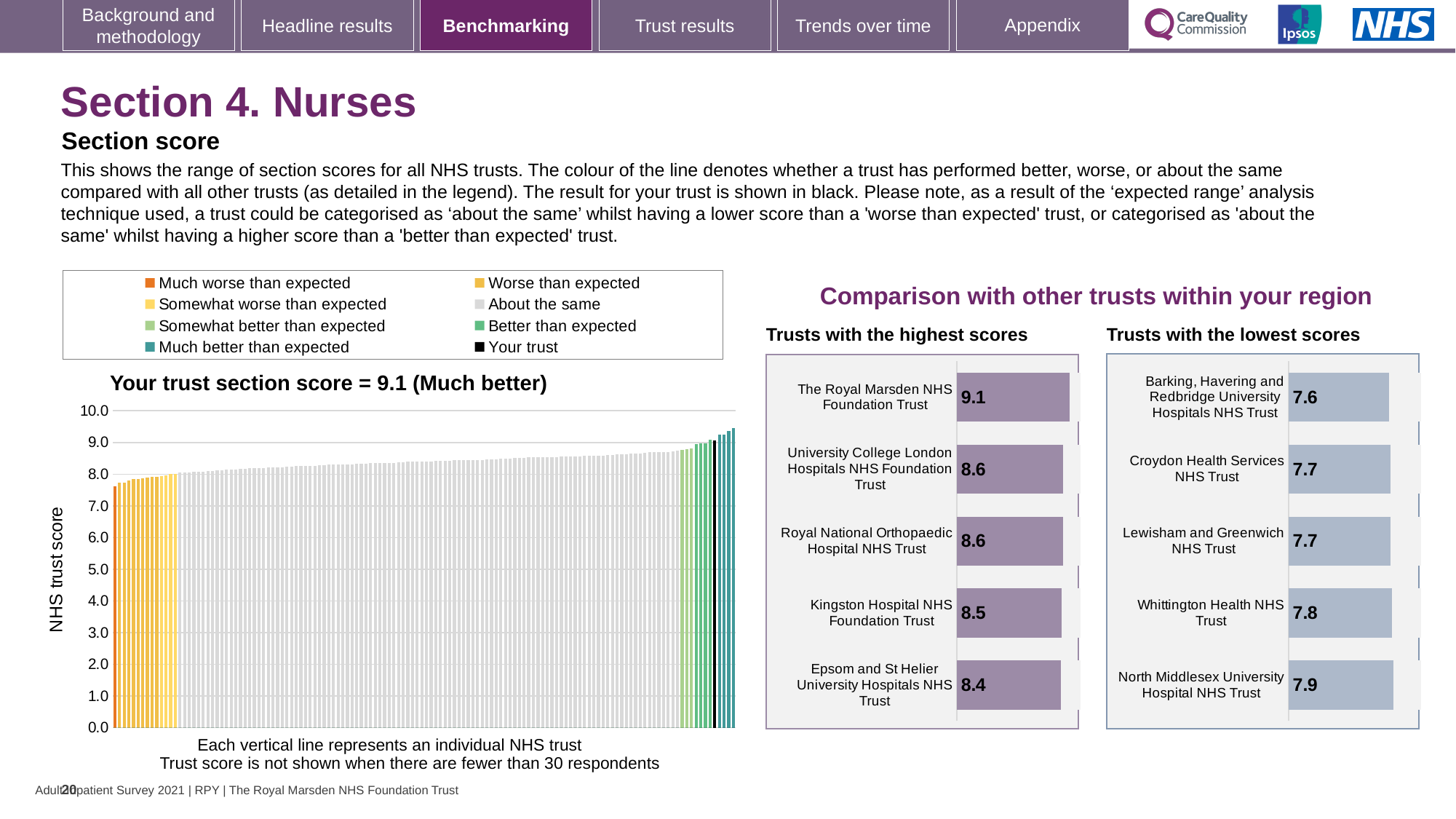
In the 'Trusts with the lowest scores' chart, what is the score for Croydon Health Services NHS Trust? 7.7 In the 'Trusts with the highest scores' chart, which trust has the highest score? The Royal Marsden NHS Foundation Trust In the 'Trusts with the lowest scores' chart, which trust has the lowest score? Barking, Havering and Redbridge University Hospitals NHS Trust In the 'Trusts with the highest scores' chart, what is the score for The Royal Marsden NHS Foundation Trust? 9.1 In the 'Trusts with the lowest scores' chart, what is the difference between the scores of North Middlesex University Hospital NHS Trust and Barking, Havering and Redbridge University Hospitals NHS Trust? 0.3 Which has the higher score: Kingston Hospital NHS Foundation Trust in the highest scores chart or Whittington Health NHS Trust in the lowest scores chart? Kingston Hospital NHS Foundation Trust In the main chart titled 'Your trust section score', what is the section score for your trust? 9.1 In the 'Trusts with the highest scores' chart, what is the difference between the scores of The Royal Marsden NHS Foundation Trust and Epsom and St Helier University Hospitals NHS Trust? 0.7 In the main 'Your trust section score' chart, do the trust scores rise or fall from left to right? rise How many trusts are shown in the 'Trusts with the lowest scores' chart? 5 In the 'Trusts with the highest scores' chart, what is the score for Kingston Hospital NHS Foundation Trust? 8.5 How many entries does the legend of the main 'Your trust section score' chart list? 8